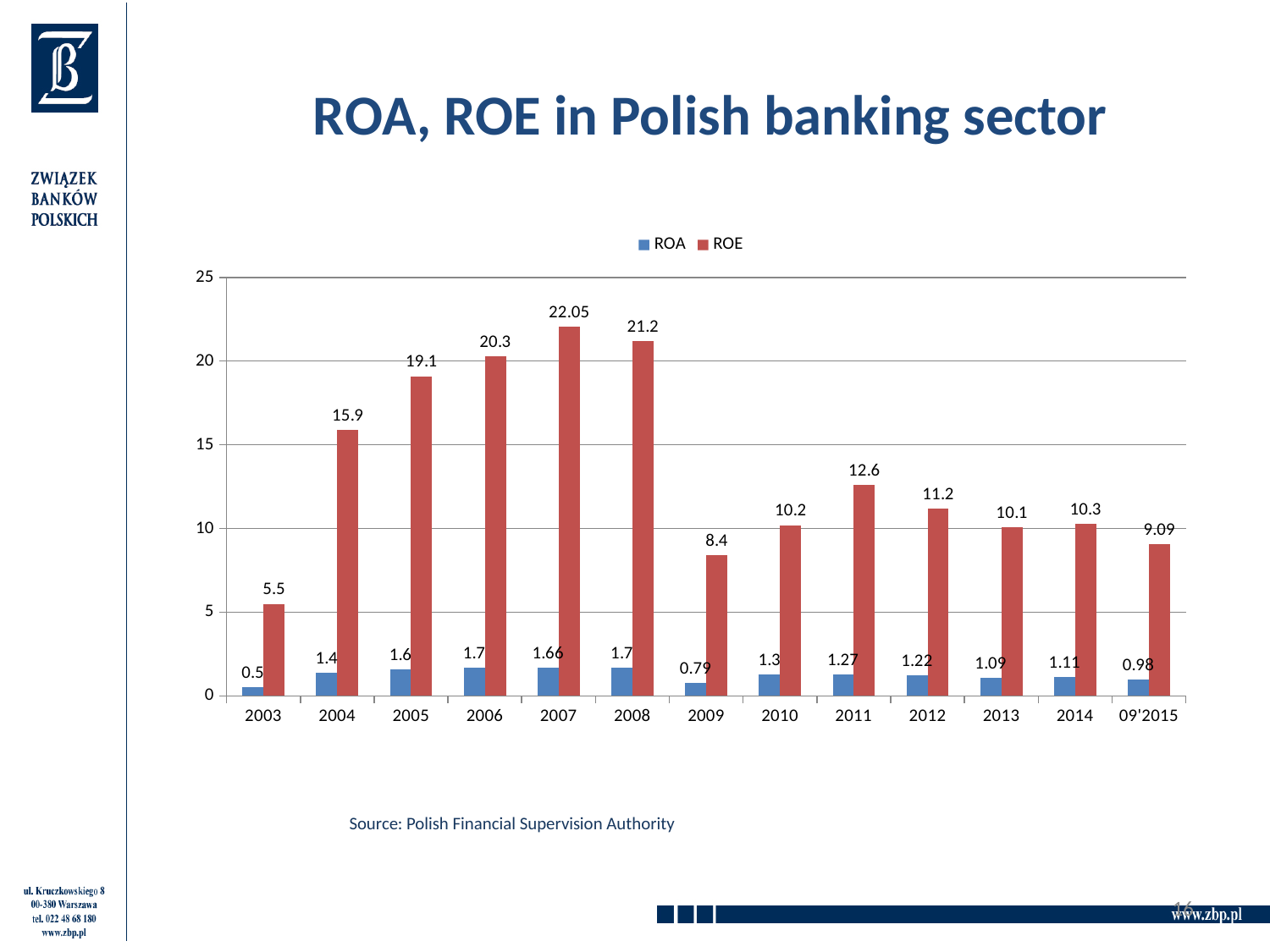
What kind of chart is shown on the slide? Bar chart How many categories are shown on the x axis? 13 Is the ROE value for 2004 greater or less than 15? greater Which year has the highest ROE? 2007 What is the ROE value for 09'2015? 9.09 Which is larger, the ROE in 2011 or the ROE in 2012? ROE in 2011 What is the ROE value for 2007? 22.05 What is the difference between the ROE in 2008 and the ROE in 2009? 12.8 What is the source cited below the chart? Polish Financial Supervision Authority Which year has the lowest ROA? 2003 What is the ROA value for 2009? 0.79 How many series does the legend list? 2